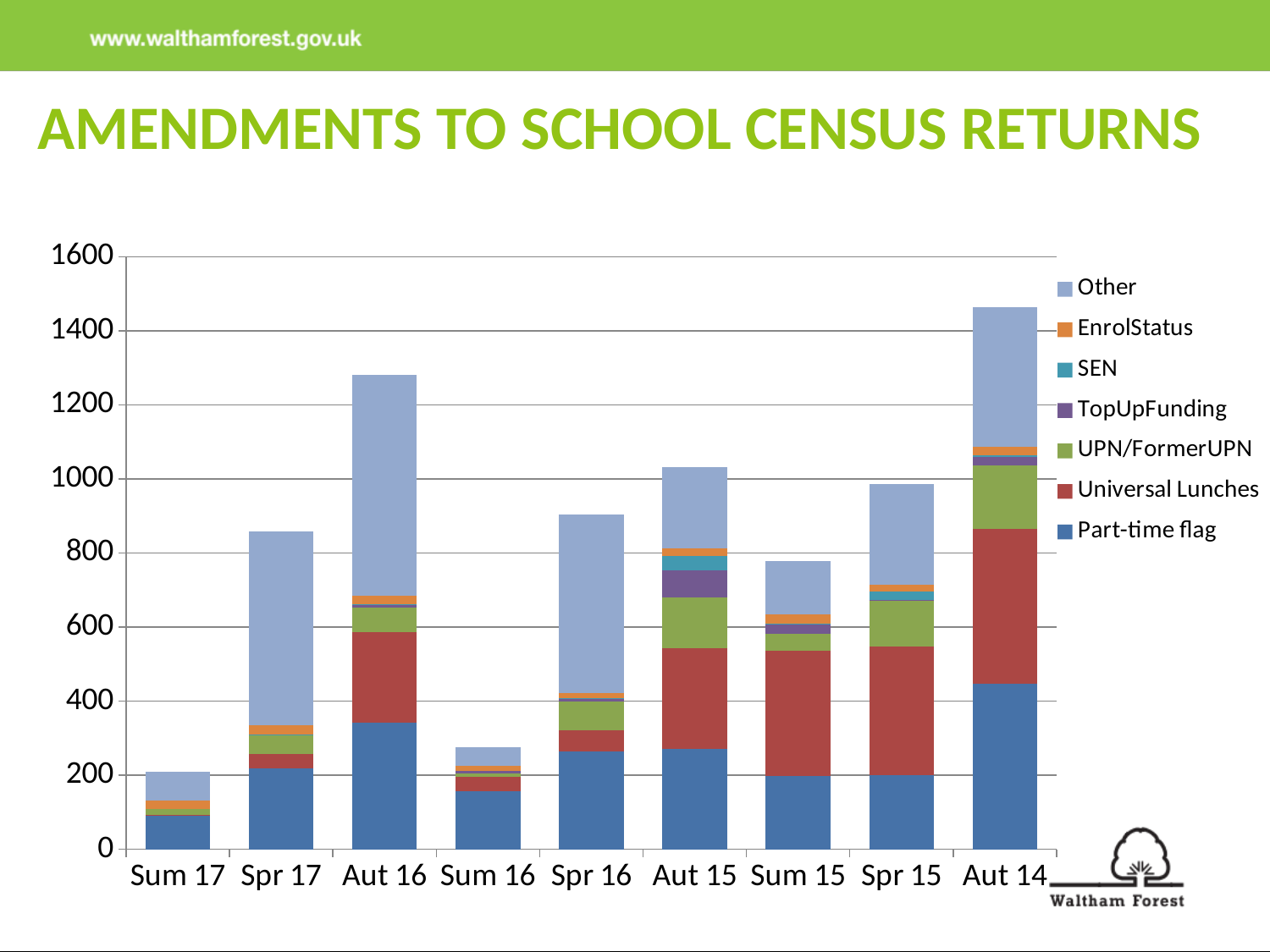
Which has the larger total bar, Aut 16 or Spr 16? Aut 16 How many series does the legend list? 7 Which census period has the shortest stacked bar overall? Sum 17 What kind of chart is shown on the slide? Stacked bar chart Which census period has the tallest stacked bar overall? Aut 14 Is the total bar height for Aut 16 greater or less than 1200? greater Is the total bar height for Sum 16 greater or less than 400? less What is the title of the slide containing the chart? AMENDMENTS TO SCHOOL CENSUS RETURNS Is the Part-time flag value for Aut 14 greater or less than 400? greater How many census periods (categories) are shown along the x axis? 9 Which has the larger total bar, Spr 17 or Sum 15? Spr 17